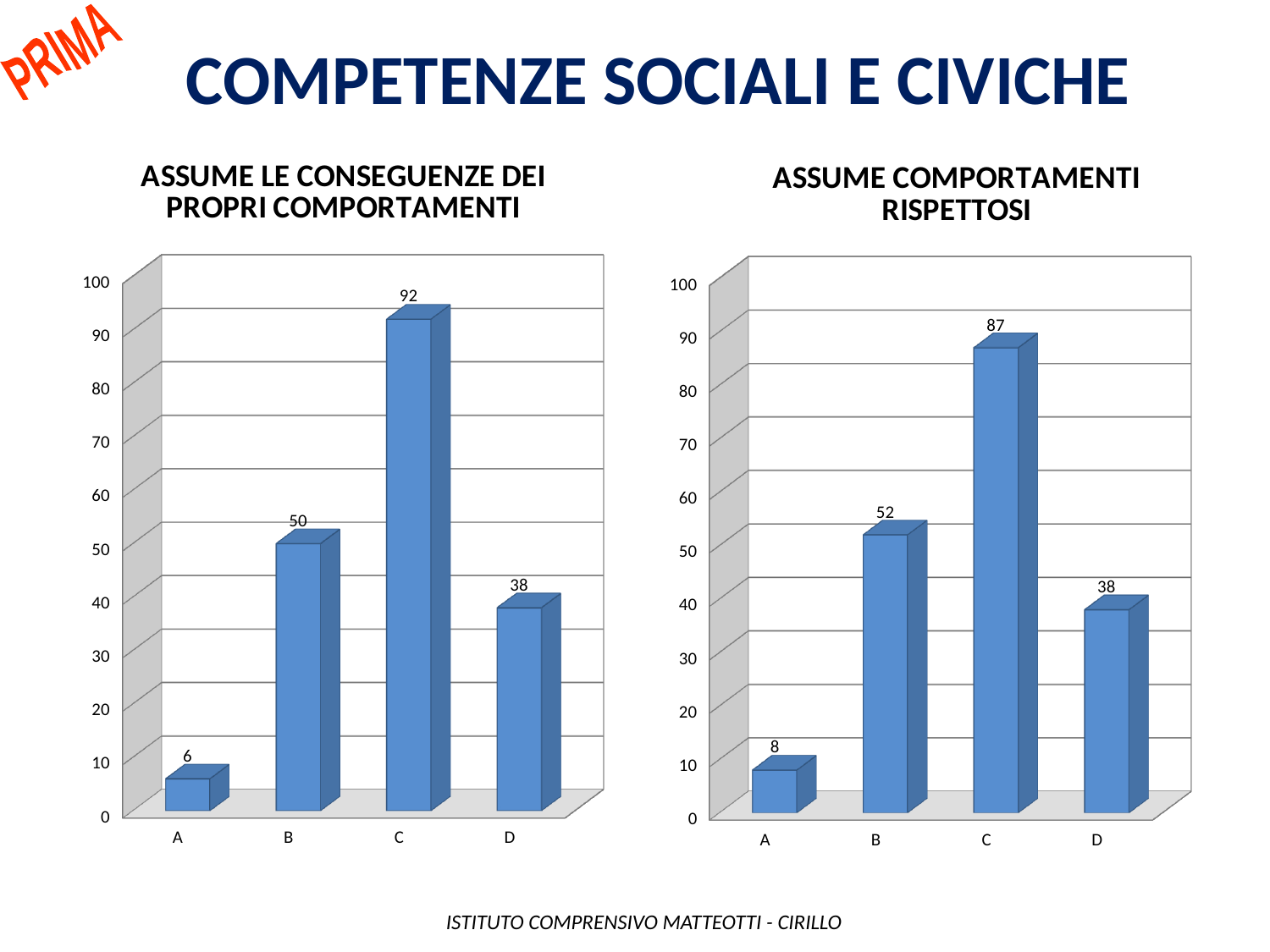
In the chart titled 'ASSUME COMPORTAMENTI RISPETTOSI', what is the value for category A? 8 In the chart titled 'ASSUME COMPORTAMENTI RISPETTOSI', what is the difference between the values for B and D? 14 In the left chart, what is the value for category B? 50 In the chart titled 'ASSUME LE CONSEGUENZE DEI PROPRI COMPORTAMENTI', what is the value for category C? 92 In the left chart, which category has the lowest value? A In the left chart, is the value for D greater or less than 40? less In the right chart, which category has the highest value? C What is the title of the chart on the right side of the slide? ASSUME COMPORTAMENTI RISPETTOSI In the right chart, which is larger, the value for B or the value for D? B In the chart titled 'ASSUME LE CONSEGUENZE DEI PROPRI COMPORTAMENTI', what is the difference between the values for C and B? 42 How many categories are shown in the chart titled 'ASSUME COMPORTAMENTI RISPETTOSI'? 4 What kind of chart is the chart titled 'ASSUME LE CONSEGUENZE DEI PROPRI COMPORTAMENTI'? Bar chart